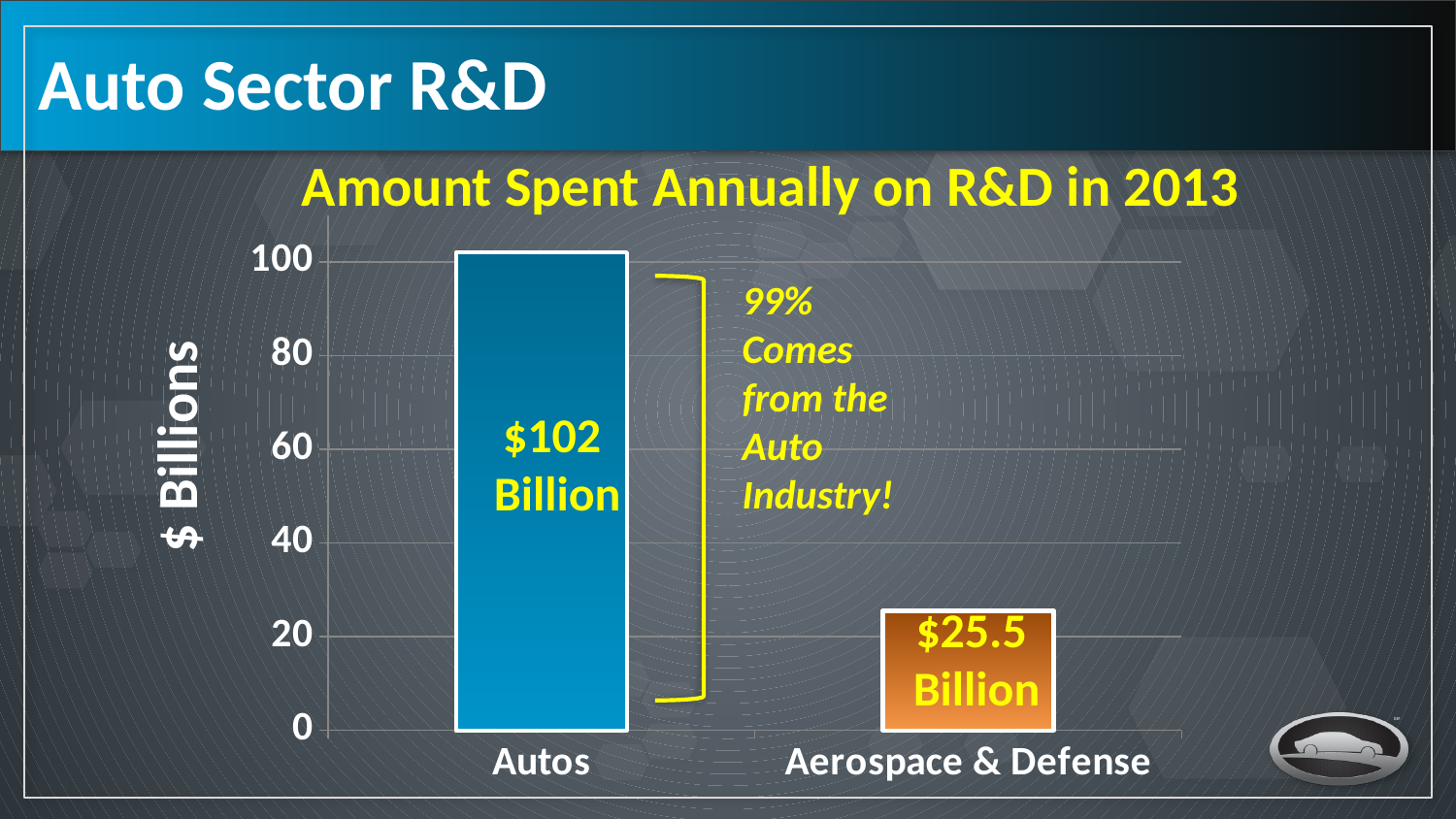
What is the difference between the Autos and Aerospace & Defense values? $76.5 Billion What kind of chart is shown? bar chart What is the value for Autos? $102 Billion Is the value for Aerospace & Defense greater or less than 40? less Is the value for Autos greater or less than 80? greater What is the title of the chart? Amount Spent Annually on R&D in 2013 What is the label on the y axis? $ Billions Which category has the highest R&D spending? Autos Which is larger, the value for Autos or the value for Aerospace & Defense? Autos What is the value for Aerospace & Defense? $25.5 Billion Which category has the lowest R&D spending? Aerospace & Defense How many categories are shown on the x axis? 2